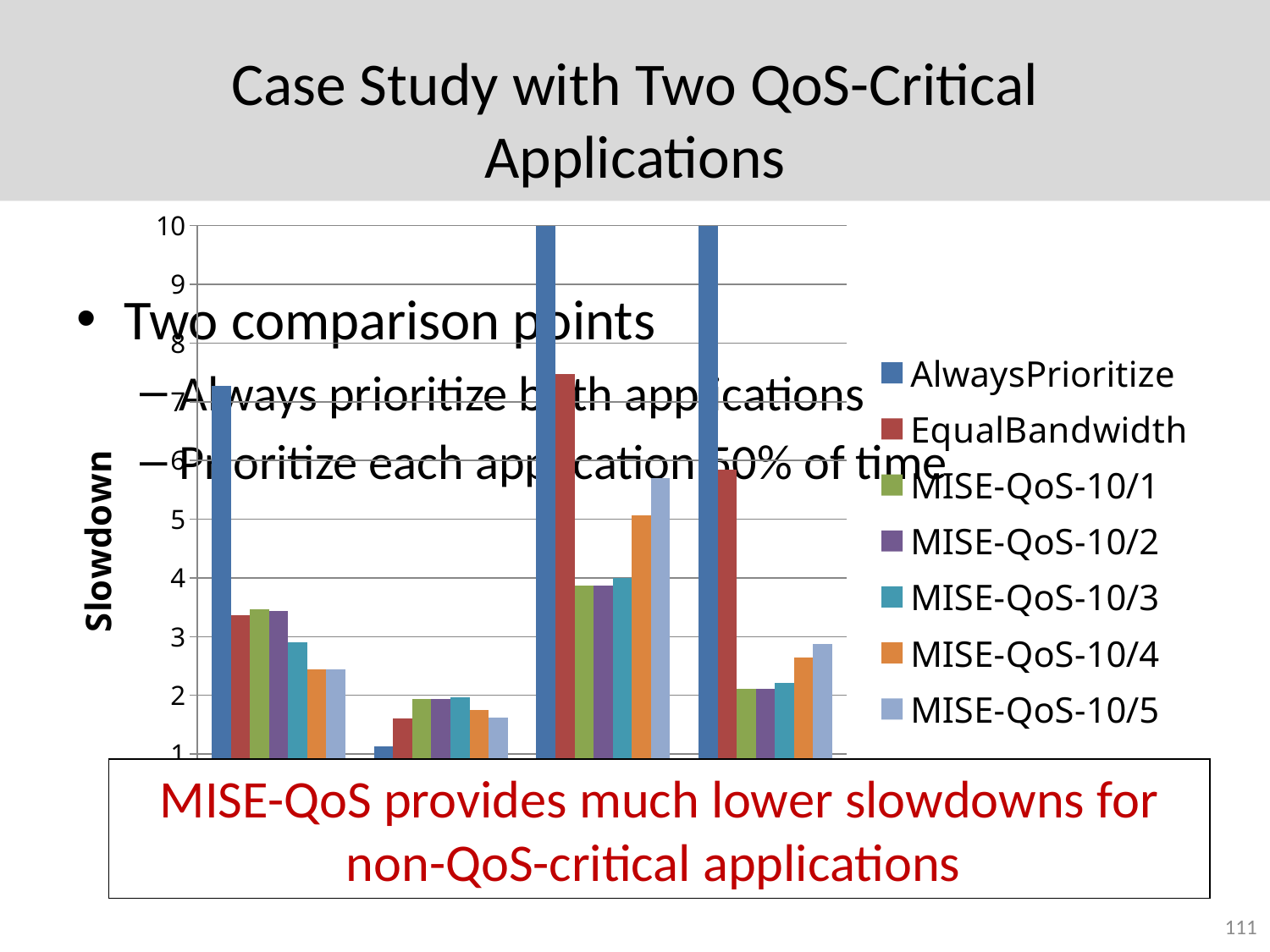
How many series does the chart's legend list? 7 In the leftmost group of bars, is the value for MISE-QoS-10/5 greater or less than 3? less In the rightmost group of bars, which is larger: the value for EqualBandwidth or the value for MISE-QoS-10/1? EqualBandwidth In the third group of bars from the left, is the value for MISE-QoS-10/5 greater or less than 5? greater What is the label of the chart's vertical axis? Slowdown In the leftmost group of bars, is the value for AlwaysPrioritize greater or less than 6? greater In the third group of bars from the left, which is larger: the value for MISE-QoS-10/1 or the value for MISE-QoS-10/5? MISE-QoS-10/5 How many groups of bars are plotted along the x axis? 4 What kind of chart is shown on the slide? bar chart Which series is listed first in the chart's legend? AlwaysPrioritize In the leftmost group of bars, which series has the highest value? AlwaysPrioritize